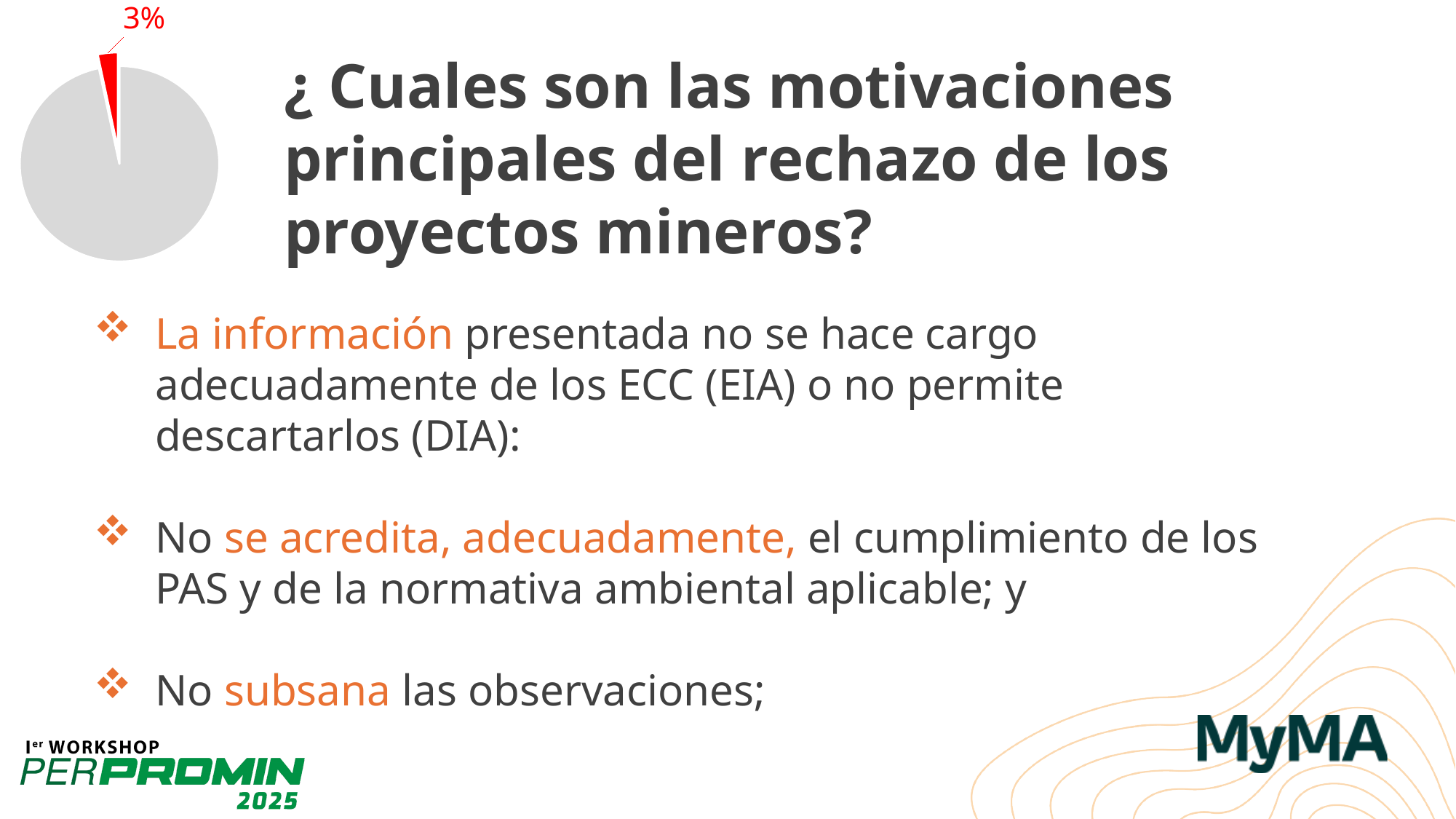
What kind of chart is shown in the top-left corner of the slide? pie chart What percentage is printed as the data label on the pie chart? 3% Does the pie chart display a legend? No How many slices does the pie chart have? 2 What share of the pie does the red slice represent? 3% Which slice of the pie chart is the smallest? the red slice What colour is the slice of the pie chart that carries the 3% label? red Which slice of the pie chart is larger, the red slice or the grey slice? the grey slice